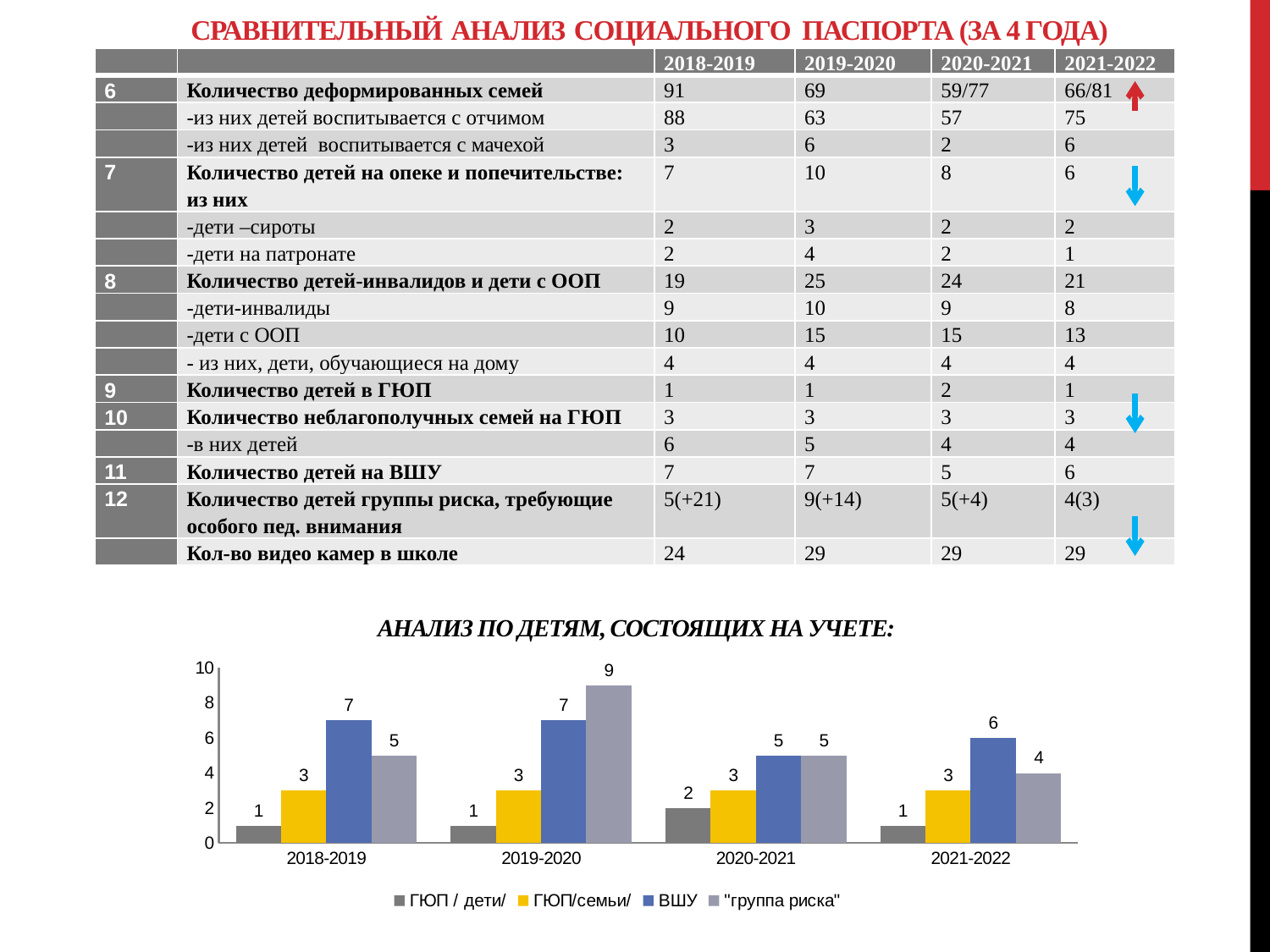
In the bar chart, which year has the lowest value for ВШУ? 2020-2021 How many series does the legend of the bar chart list? 4 In the bar chart, what is the difference between the ВШУ value and the "ГЮП/семьи/" value for 2018-2019? 4 In the bar chart, which series is shown in yellow? ГЮП/семьи/ In the bar chart, does the value of "группа риска" rise or fall from 2019-2020 to 2021-2022? Fall In the bar chart, which year has the highest value for "группа риска"? 2019-2020 In the bar chart, what is the value of ВШУ for 2021-2022? 6 In the bar chart, which is larger for 2021-2022: ВШУ or "группа риска"? ВШУ What kind of chart is shown under the heading "АНАЛИЗ ПО ДЕТЯМ, СОСТОЯЩИХ НА УЧЕТЕ:"? Bar chart How many year categories are shown on the x axis of the bar chart? 4 In the bar chart, what is the value of "группа риска" for 2019-2020? 9 In the bar chart, what is the value of "ГЮП / дети/" for 2020-2021? 2